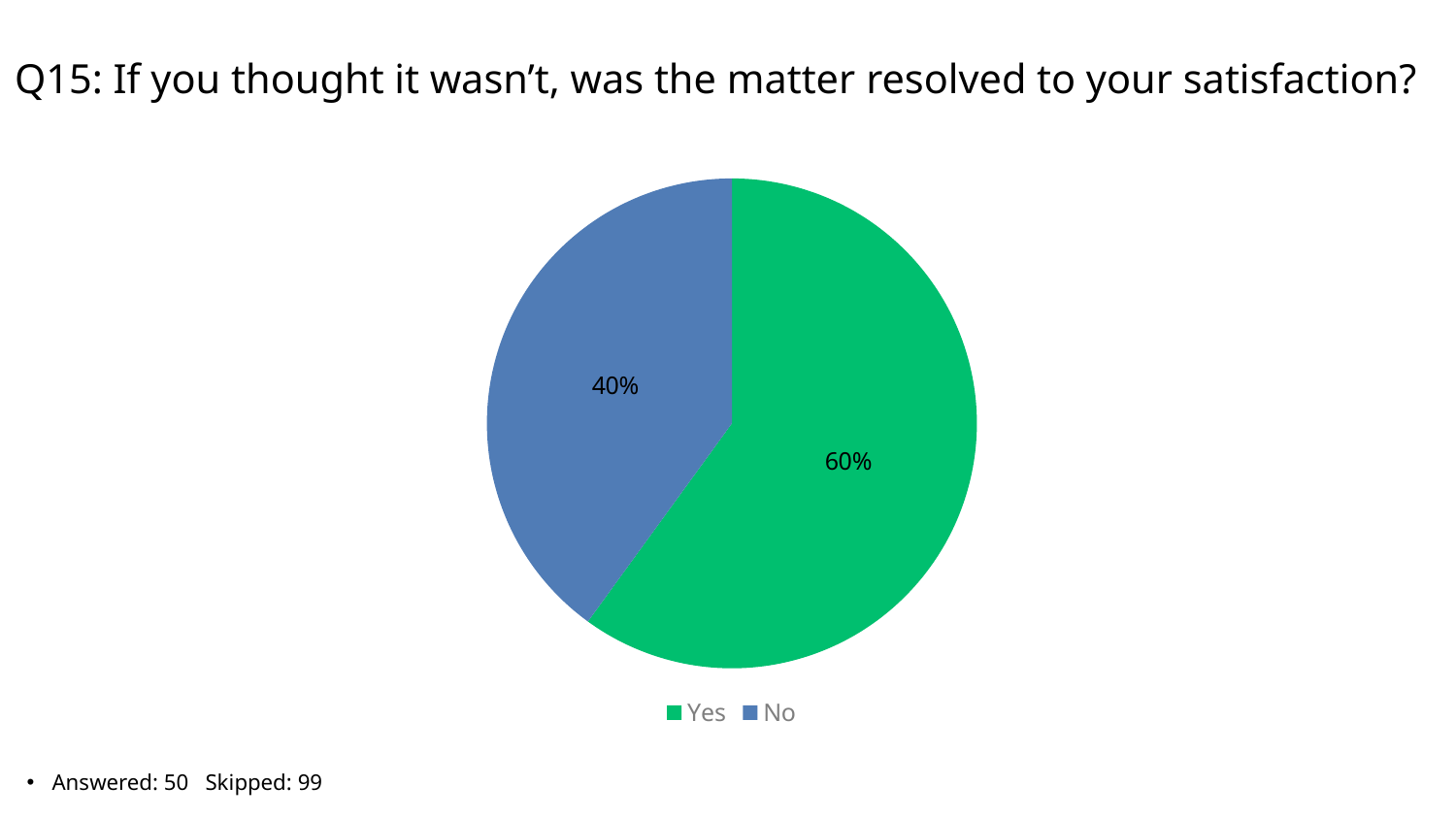
What is the difference in percentage points between the Yes and No slices? 20 percentage points What colour is the Yes slice? green What share of the pie does the No slice represent? 40% How many slices does the pie chart have? 2 Which is larger, the Yes slice or the No slice? Yes What colour is the No slice? blue How many entries does the legend list? 2 Which slice is the smallest in the pie chart? No What share of the pie does the Yes slice represent? 60% Which slice is the largest in the pie chart? Yes What kind of chart is shown on the slide? pie chart Is the share for Yes greater or less than 50%? greater